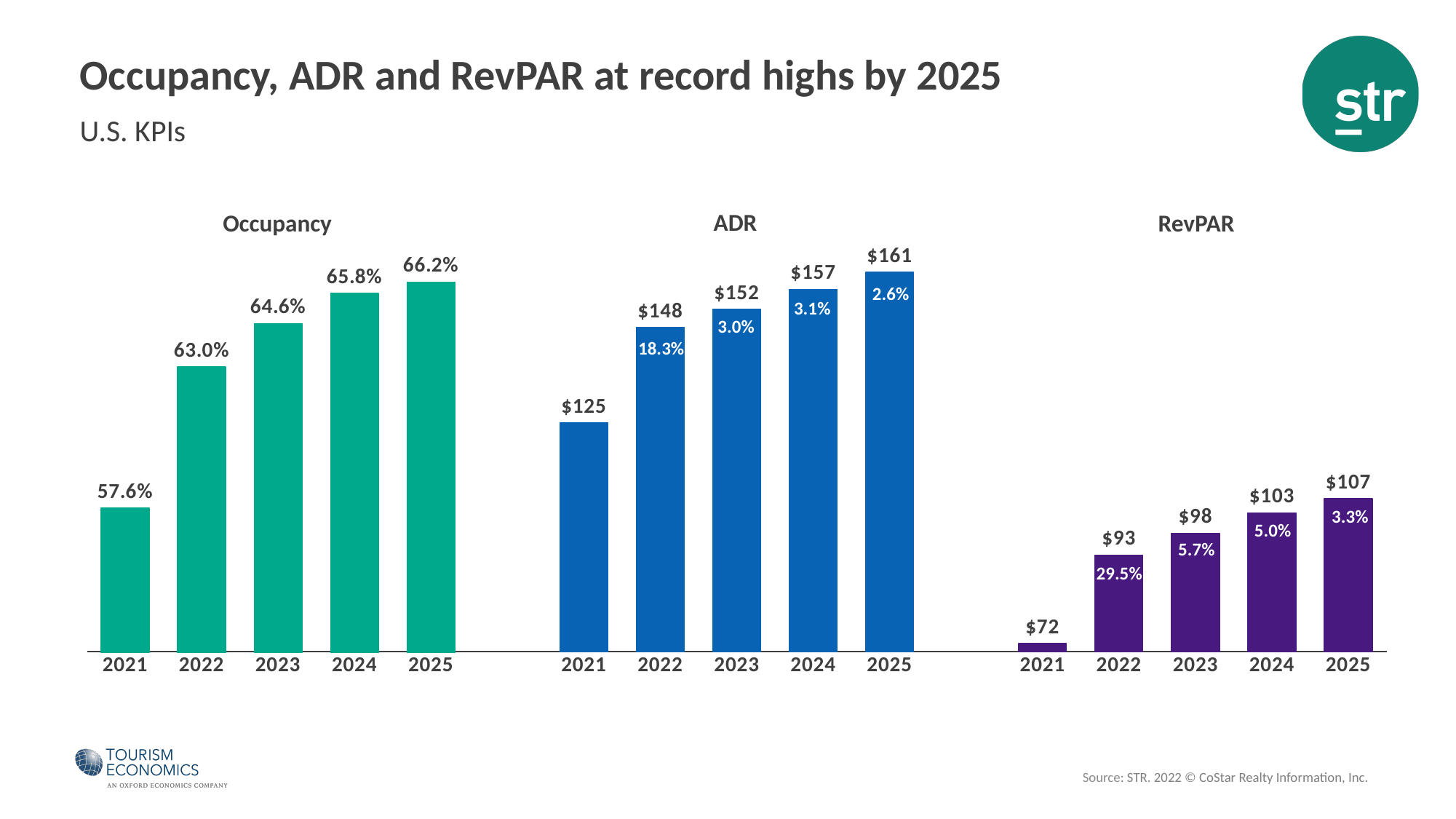
In the ADR chart, what growth rate is printed inside the 2022 bar? 18.3% How many years are shown in the ADR chart? 5 What kind of chart is the RevPAR chart? bar chart In the RevPAR chart, what is the value for 2024? $103 In the Occupancy chart, what is the value for 2021? 57.6% In the RevPAR chart, which year has the lowest value? 2021 In the ADR chart, what is the difference between the 2025 and 2021 values? $36 In the RevPAR chart, which is larger, the value for 2022 or the value for 2023? 2023 In the Occupancy chart, what is the difference between the 2022 and 2021 values? 5.4% In the Occupancy chart, which year has the highest value? 2025 In the Occupancy chart, do the values rise or fall from 2021 to 2025? rise In the ADR chart, what is the value for 2023? $152